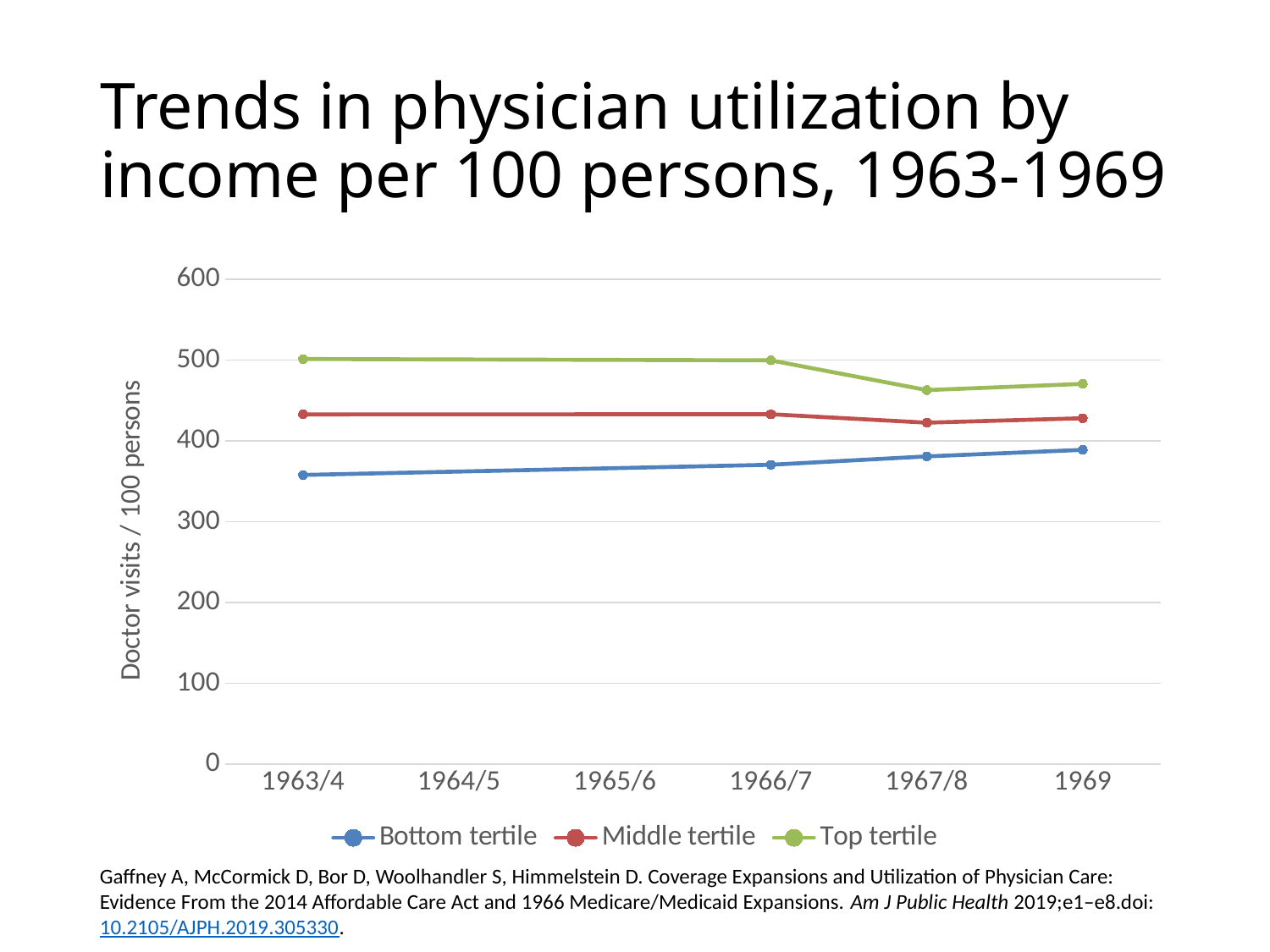
Which series has the lowest values throughout the chart? Bottom tertile Do the values for Top tertile rise or fall from 1966/7 to 1967/8? fall How many series does the legend list? 3 Which series has the highest values throughout the chart? Top tertile Is the value for Middle tertile in 1969 greater or less than 500? less Is the value for Bottom tertile in 1963/4 greater or less than 400? less How many categories are labelled on the x axis? 6 Do the values for Bottom tertile rise or fall from 1963/4 to 1969? rise Is the value for Top tertile in 1963/4 greater or less than 400? greater What kind of chart is shown on the slide? line chart What is the label on the y axis? Doctor visits / 100 persons Which is larger in 1969, the value for Middle tertile or the value for Bottom tertile? Middle tertile